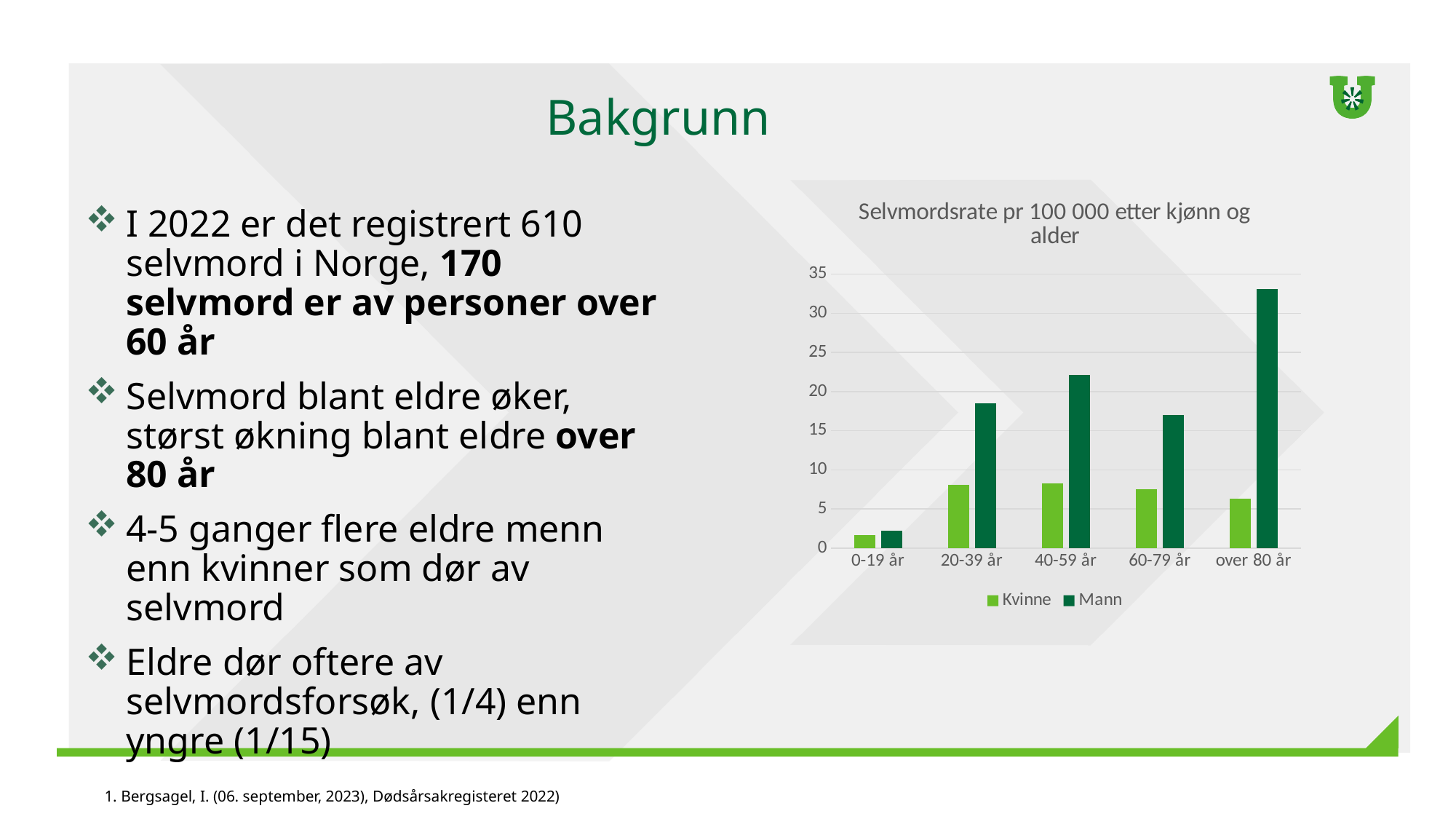
What kind of chart is shown on the slide? bar chart Is the value for Mann in the over 80 år category greater or less than 30? greater Which age category has the lowest value for Kvinne? 0-19 år Is the value for Mann in the 60-79 år category greater or less than 20? less How many age categories are shown on the x axis of the chart? 5 In the 60-79 år category, which series has the larger value, Kvinne or Mann? Mann What is the title of the chart? Selvmordsrate pr 100 000 etter kjønn og alder Which age category has the highest value for Mann? over 80 år For Mann, which is larger, the value for 40-59 år or the value for 60-79 år? 40-59 år Is the value for Kvinne in the 20-39 år category greater or less than 10? less Which age category has the lowest value for Mann? 0-19 år How many series does the chart legend list? 2